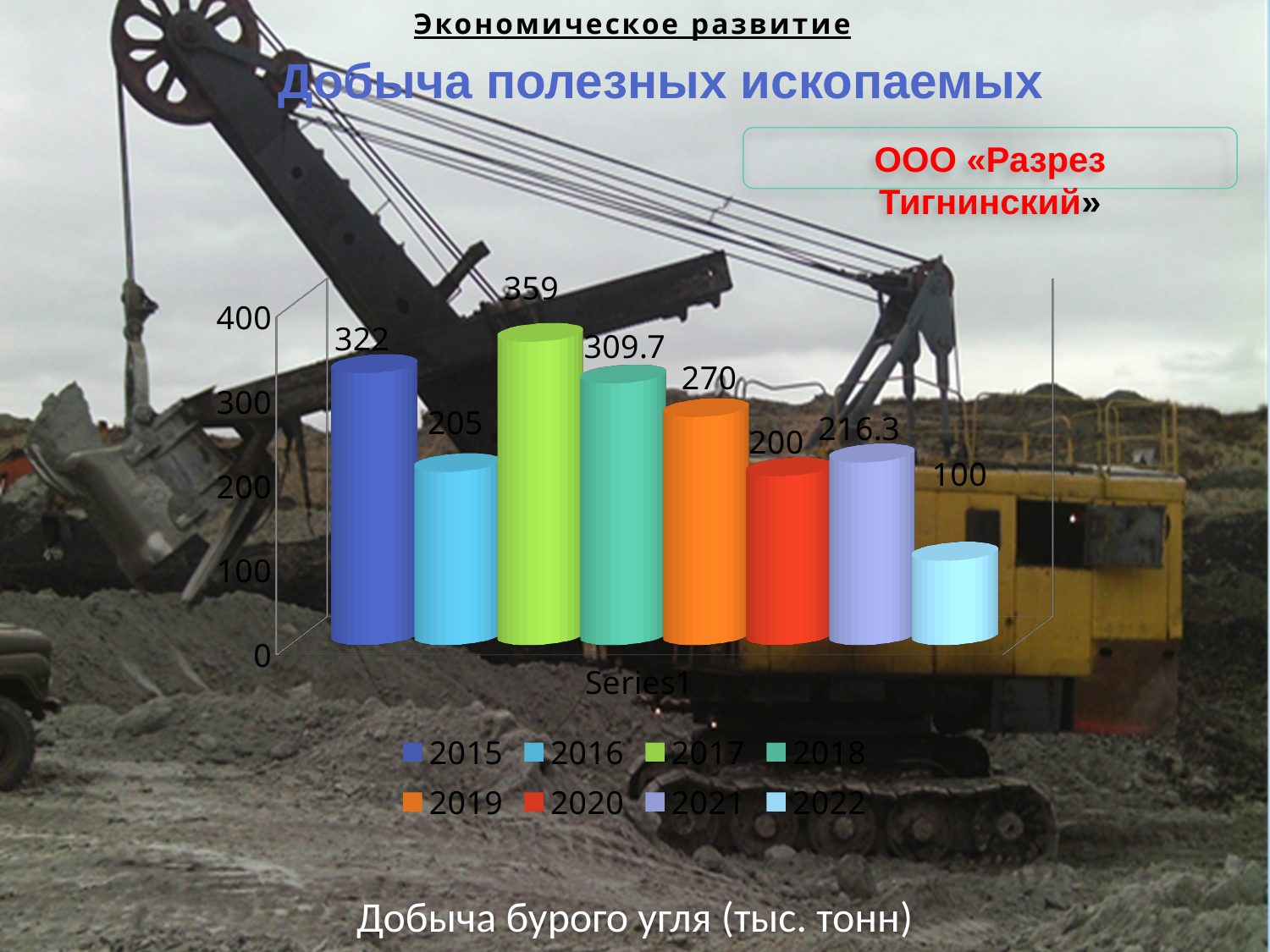
What is the caption below the chart? Добыча бурого угля (тыс. тонн) What is the difference between the values for 2015 and 2016? 117 What is the value shown for 2017? 359 Which year has the highest value? 2017 What kind of chart is shown on the slide? bar chart What is the value shown for 2022? 100 Which year has the lowest value? 2022 What is the value shown for 2018? 309.7 What is the difference between the values for 2017 and 2022? 259 How many series does the legend list? 8 What is the value shown for 2021? 216.3 Which is larger, the value for 2019 or the value for 2020? 2019